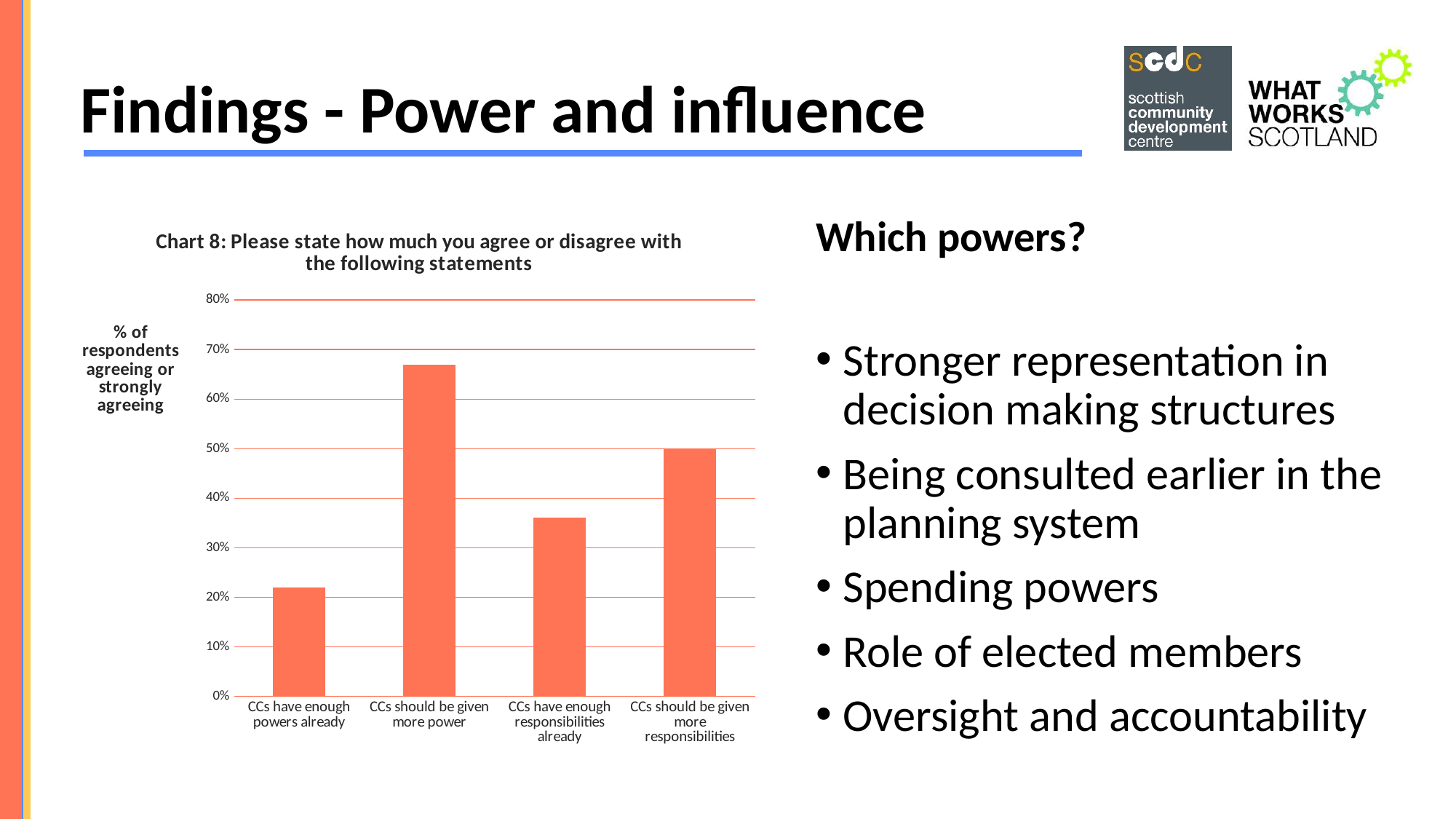
What percentage of respondents agree or strongly agree that CCs should be given more responsibilities? 50% How many statements (categories) are plotted in Chart 8? 4 Is the value for 'CCs have enough powers already' greater or less than 30%? less Is the value for 'CCs have enough responsibilities already' greater or less than 30%? greater What is the title of the chart on the slide? Chart 8: Please state how much you agree or disagree with the following statements Is the value for 'CCs have enough responsibilities already' greater or less than 40%? less What does the vertical axis of the chart measure? % of respondents agreeing or strongly agreeing What kind of chart is shown on the slide? Bar chart Which statement has the highest percentage of respondents agreeing or strongly agreeing? CCs should be given more power Which statement has the lowest percentage of respondents agreeing or strongly agreeing? CCs have enough powers already Which is larger: the value for 'CCs should be given more power' or the value for 'CCs should be given more responsibilities'? CCs should be given more power